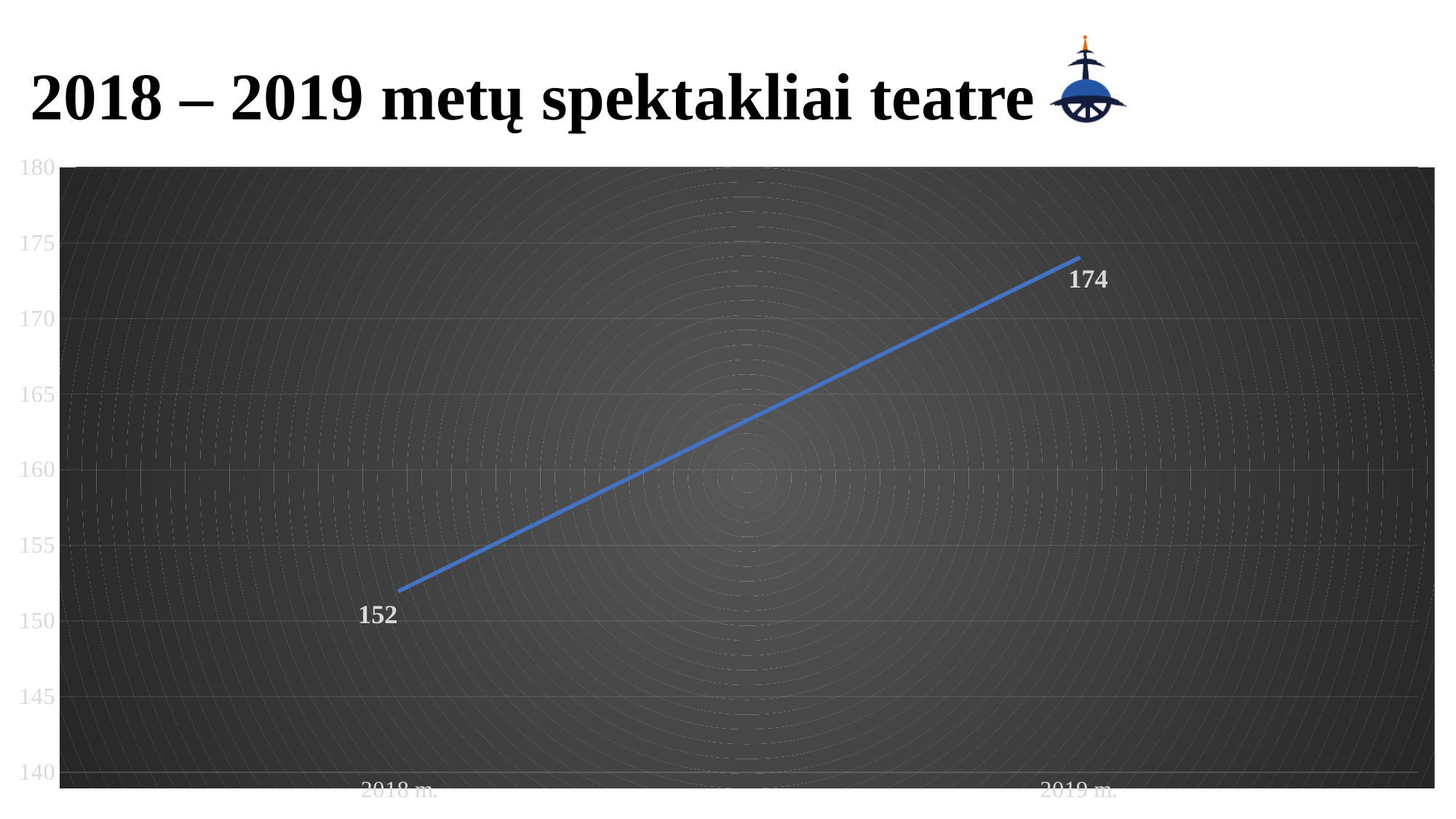
Do the values rise or fall from 2018 m. to 2019 m.? Rise How many data points are plotted on the chart? 2 Is the value for 2019 m. larger than the value for 2018 m.? Yes What is the value for 2019 m.? 174 Which year has the lower value? 2018 m. What kind of chart is shown on the slide? Line chart Is the value for 2018 m. greater or less than 160? less What is the value for 2018 m.? 152 Is the value for 2019 m. greater or less than 170? greater Which year has the higher value? 2019 m. What is the title of the slide? 2018 – 2019 metų spektakliai teatre What is the difference between the values for 2019 m. and 2018 m.? 22